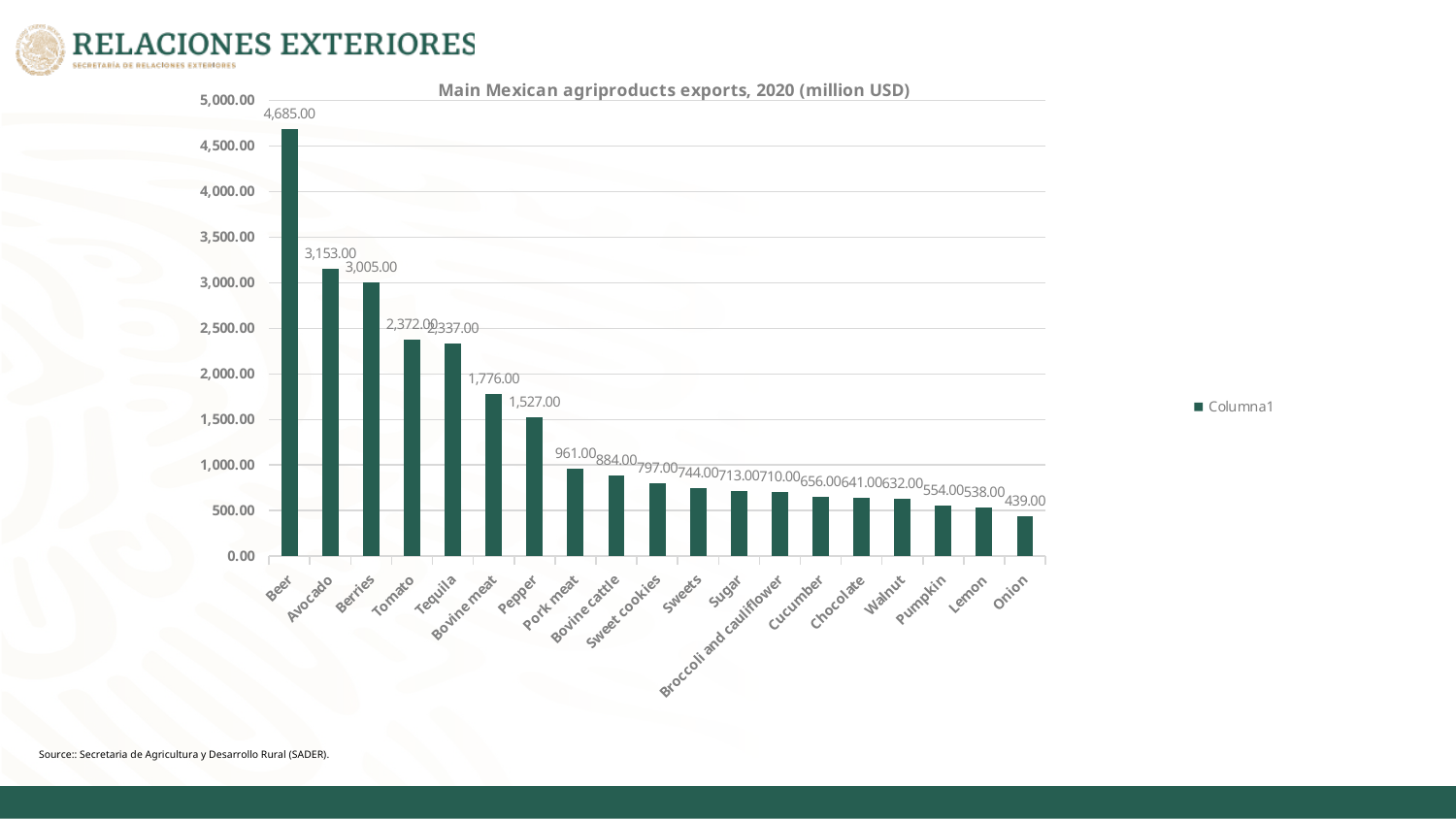
What kind of chart is shown on the slide? Bar chart What is the value for Walnut? 632.00 How many categories are shown on the x axis? 19 What is the value for Avocado? 3,153.00 Which category has the lowest value? Onion Which is larger, the value for Tomato or the value for Tequila? Tomato Which category has the highest value? Beer What is the value for Beer? 4,685.00 What is the value for Pepper? 1,527.00 What is the difference between the values for Beer and Avocado? 1,532.00 Do the values rise or fall from left to right along the x axis? Fall Is the value for Bovine meat greater or less than 1,500.00? greater